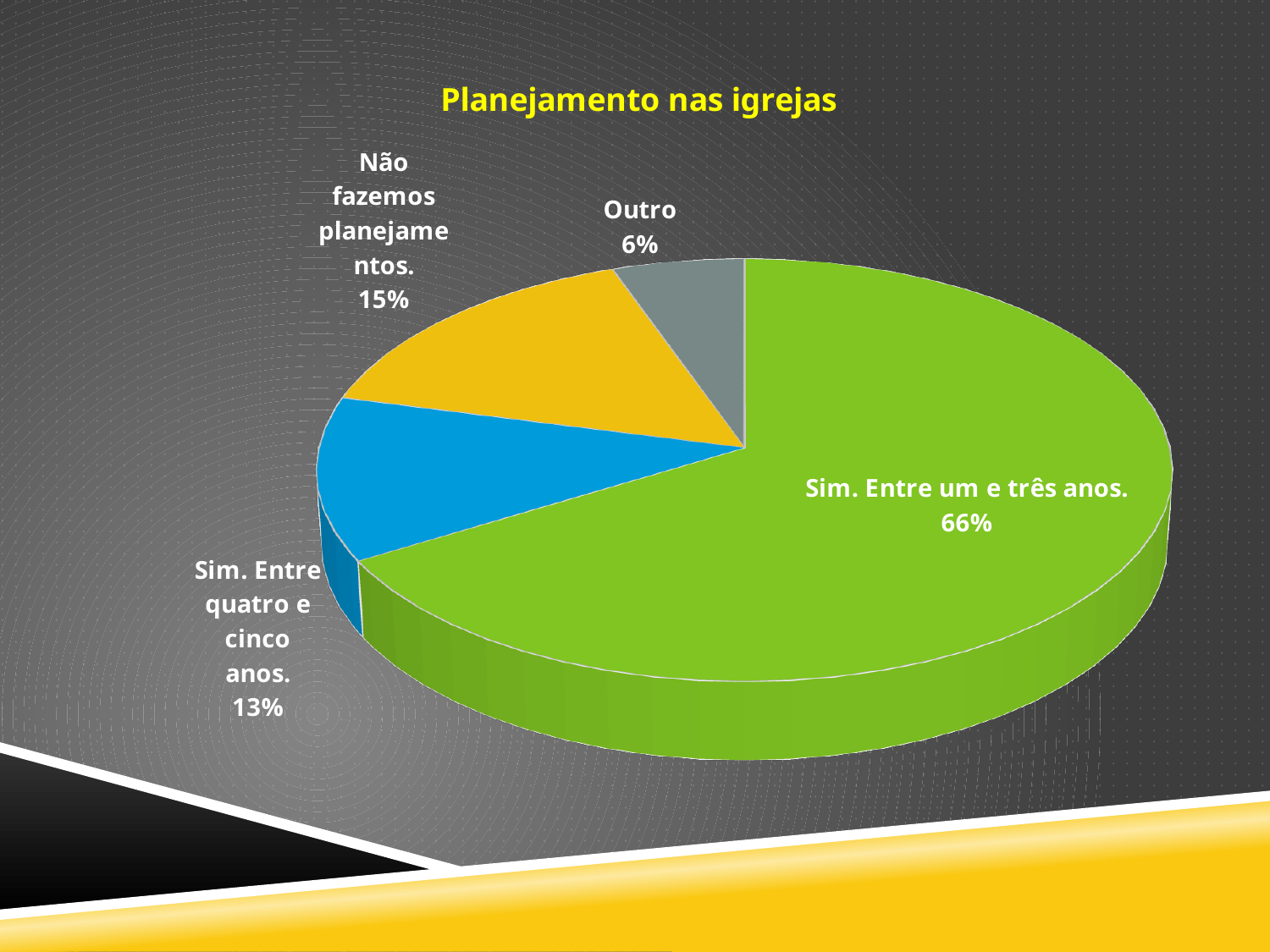
Which category has the largest share of the pie? Sim. Entre um e três anos. Which category has the smallest share of the pie? Outro What percentage is shown for "Outro"? 6% What percentage is shown for "Sim. Entre quatro e cinco anos."? 13% What percentage is shown for "Não fazemos planejamentos."? 15% What is the difference in percentage points between "Sim. Entre um e três anos." and "Não fazemos planejamentos."? 51 What colour is the slice for "Sim. Entre quatro e cinco anos."? Blue What is the title of the chart? Planejamento nas igrejas What kind of chart is shown on the slide? Pie chart Which is larger: the share for "Não fazemos planejamentos." or the share for "Outro"? Não fazemos planejamentos. What percentage is shown for "Sim. Entre um e três anos."? 66% How many slices does the pie chart have? 4